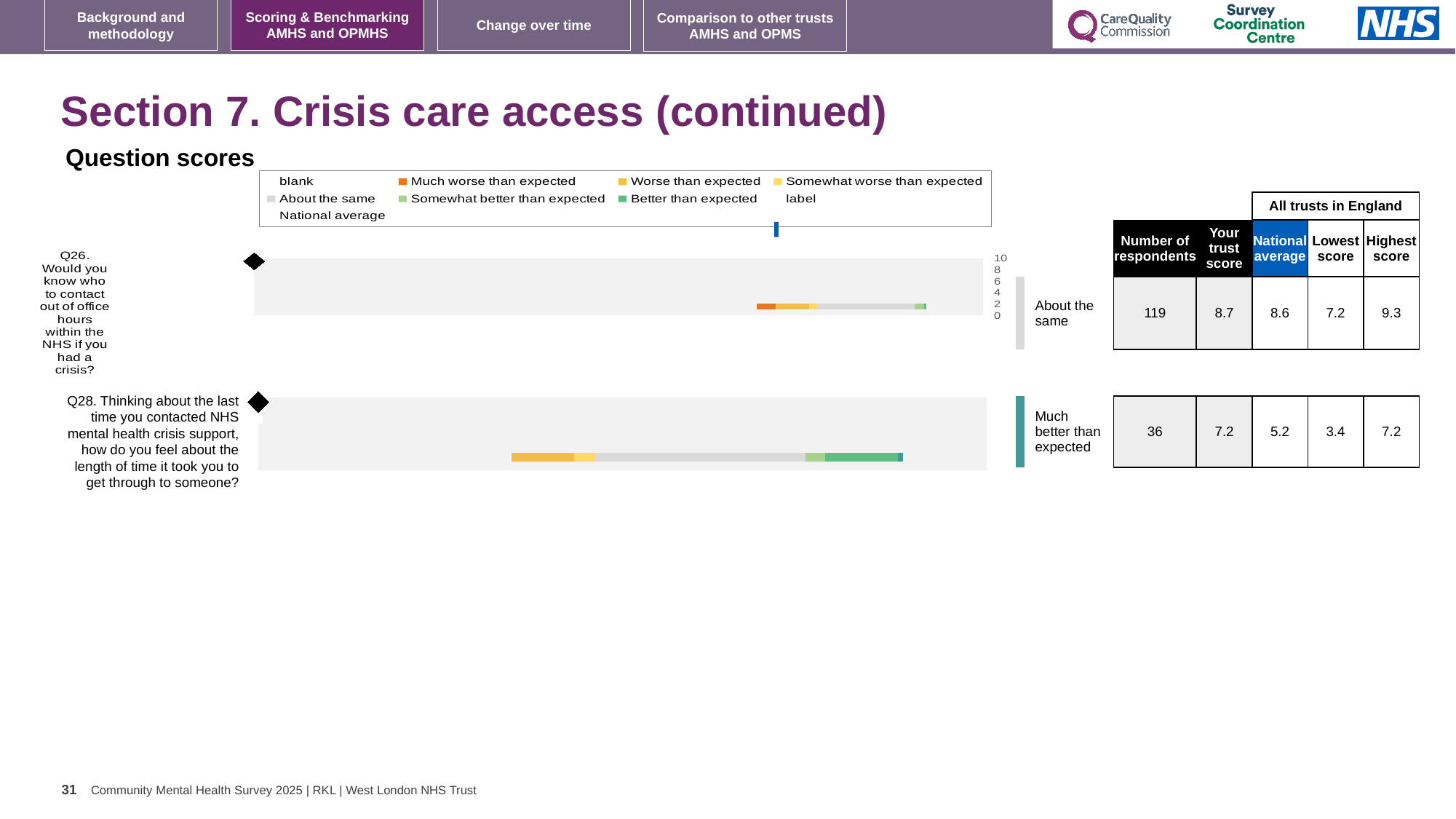
In the chart legend, which colour represents 'Much worse than expected'? orange In the table beside the chart, what is the highest score across all trusts in England for Q26? 9.3 In the chart legend, which colour represents 'About the same'? grey In the table beside the chart, what is the trust score for Q26? 8.7 Which benchmark category is shown next to the bar for Q28? Much better than expected In the table beside the chart, what is the number of respondents for Q28? 36 In the table beside the chart, what is the difference between the trust score and the national average for Q28? 2.0 In the table beside the chart, which is larger for Q28: the trust score or the national average? trust score In the table beside the chart, what is the national average for Q28? 5.2 How many questions are plotted in the question scores chart? 2 Which benchmark category is shown next to the bar for Q26? About the same What type of chart is used to show the question scores on this slide? bar chart